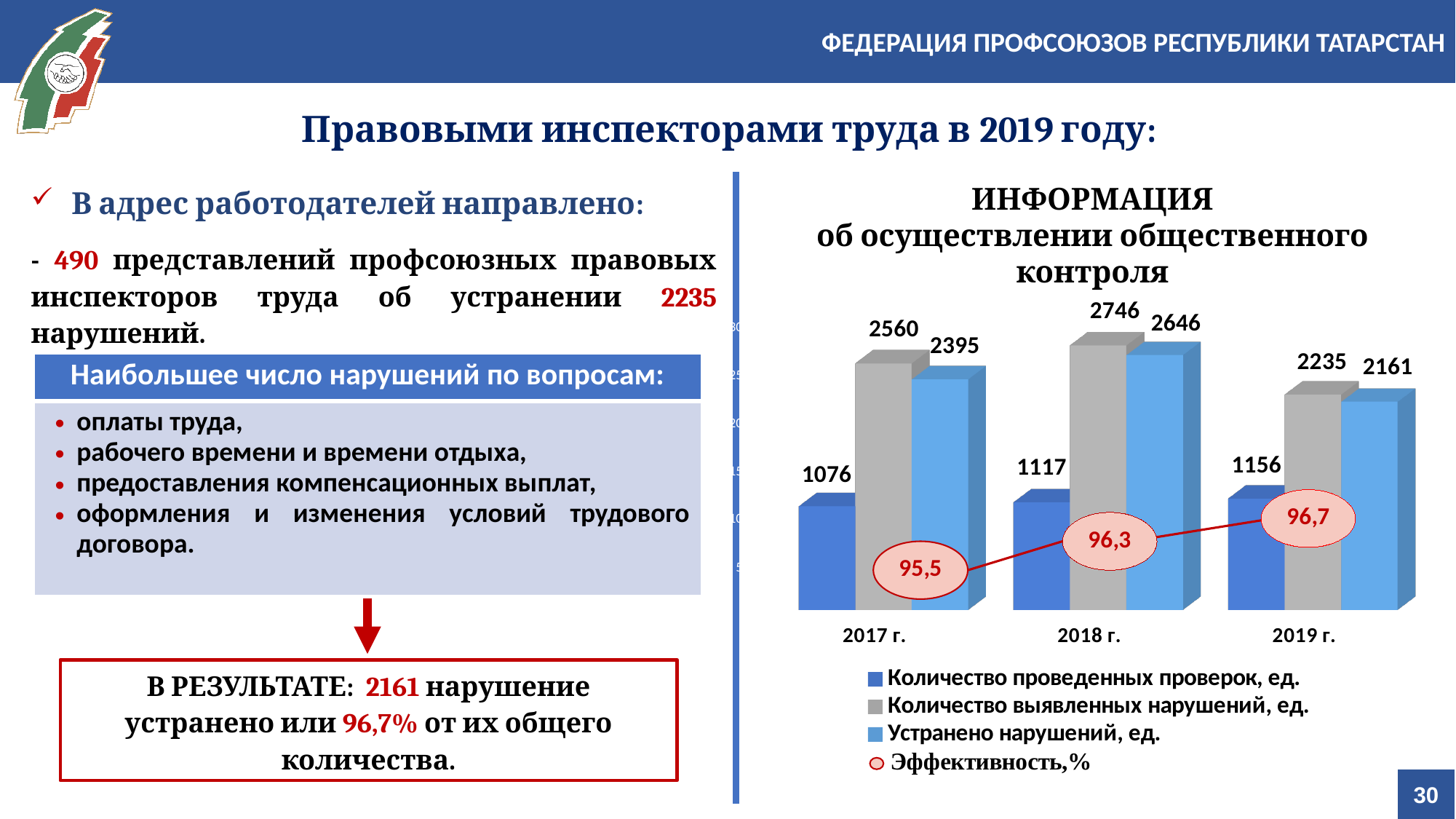
How many series does the chart legend list? 4 What is the number of identified violations (Количество выявленных нарушений) in 2018 г.? 2746 Which is larger in 2019 г.: the number of identified violations (2235) or the number of eliminated violations (2161)? Количество выявленных нарушений (2235) What is the number of conducted inspections (Количество проведенных проверок) in 2017 г.? 1076 In which year is the number of identified violations (Количество выявленных нарушений) highest? 2018 г. How many years (categories) are shown on the x axis of the chart? 3 What is the number of eliminated violations (Устранено нарушений) in 2019 г.? 2161 What is the efficiency (Эффективность, %) value shown for 2018 г.? 96,3 What is the difference between identified violations and eliminated violations in 2017 г.? 165 In which year is the number of conducted inspections (Количество проведенных проверок) lowest? 2017 г. Does the efficiency (Эффективность, %) rise or fall from 2017 г. to 2019 г.? Rises What kind of chart is shown on the slide? Bar chart